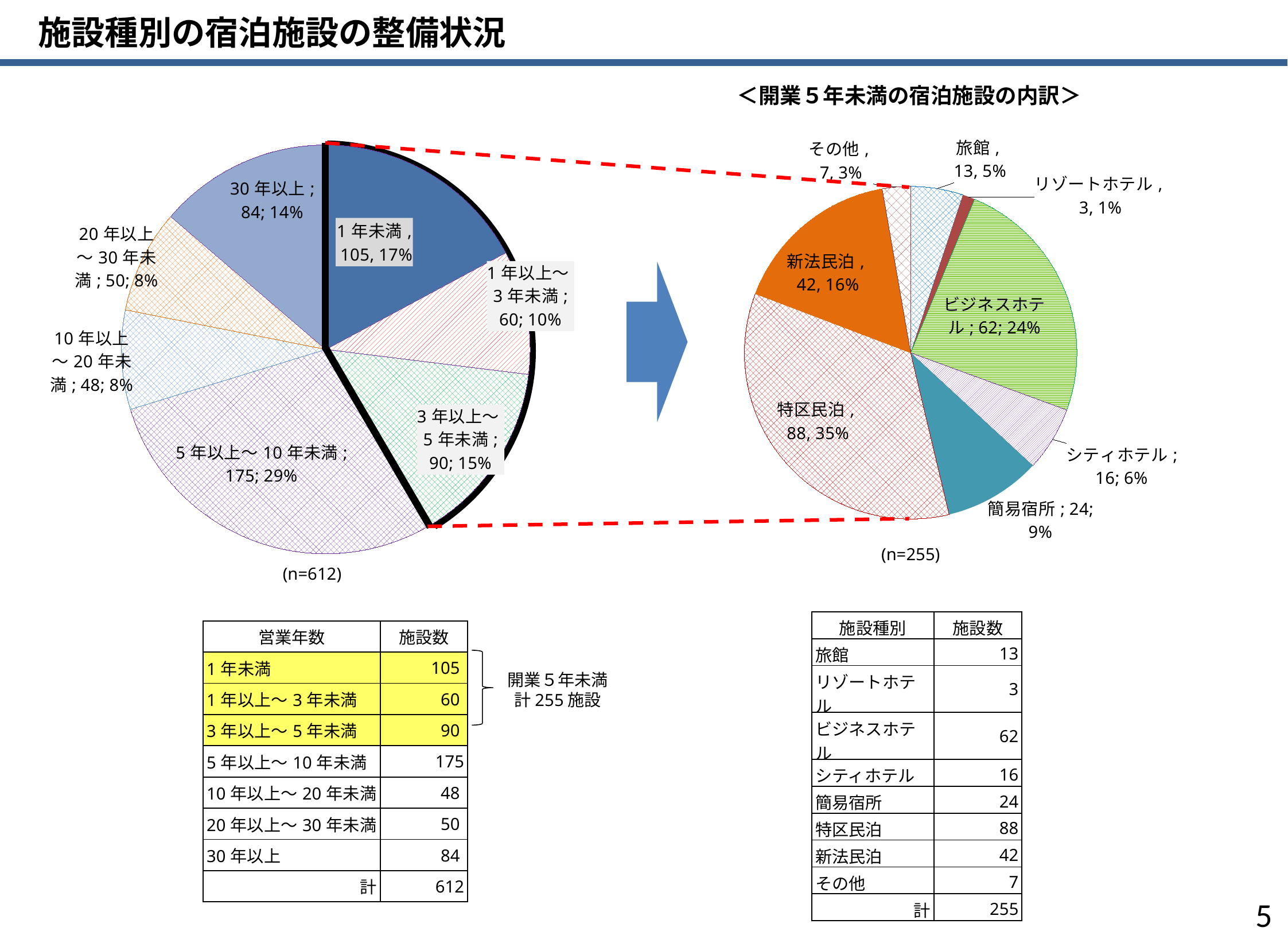
In the left pie chart (n=612), how many categories are shown? 7 In the right pie chart (開業5年未満の宿泊施設の内訳), what is the value for 新法民泊? 42, 16% In the left pie chart (n=612), what share of the pie does 30年以上 represent? 14% In the left pie chart (n=612), what is the difference between the values for 1年未満 and 3年以上～5年未満? 15 In the right pie chart (開業5年未満の宿泊施設の内訳), which is larger, ビジネスホテル or 簡易宿所? ビジネスホテル In the left pie chart (n=612), which category has the smallest slice? 10年以上～20年未満 In the right pie chart (開業5年未満の宿泊施設の内訳), how many categories are shown? 8 In the left pie chart (n=612), which category has the largest slice? 5年以上～10年未満 What kind of chart is the left chart (n=612)? pie chart In the right pie chart (開業5年未満の宿泊施設の内訳), which category has the largest slice? 特区民泊 In the right pie chart (開業5年未満の宿泊施設の内訳), which category has the smallest slice? リゾートホテル In the left pie chart (n=612), what is the value for 5年以上～10年未満? 175; 29%